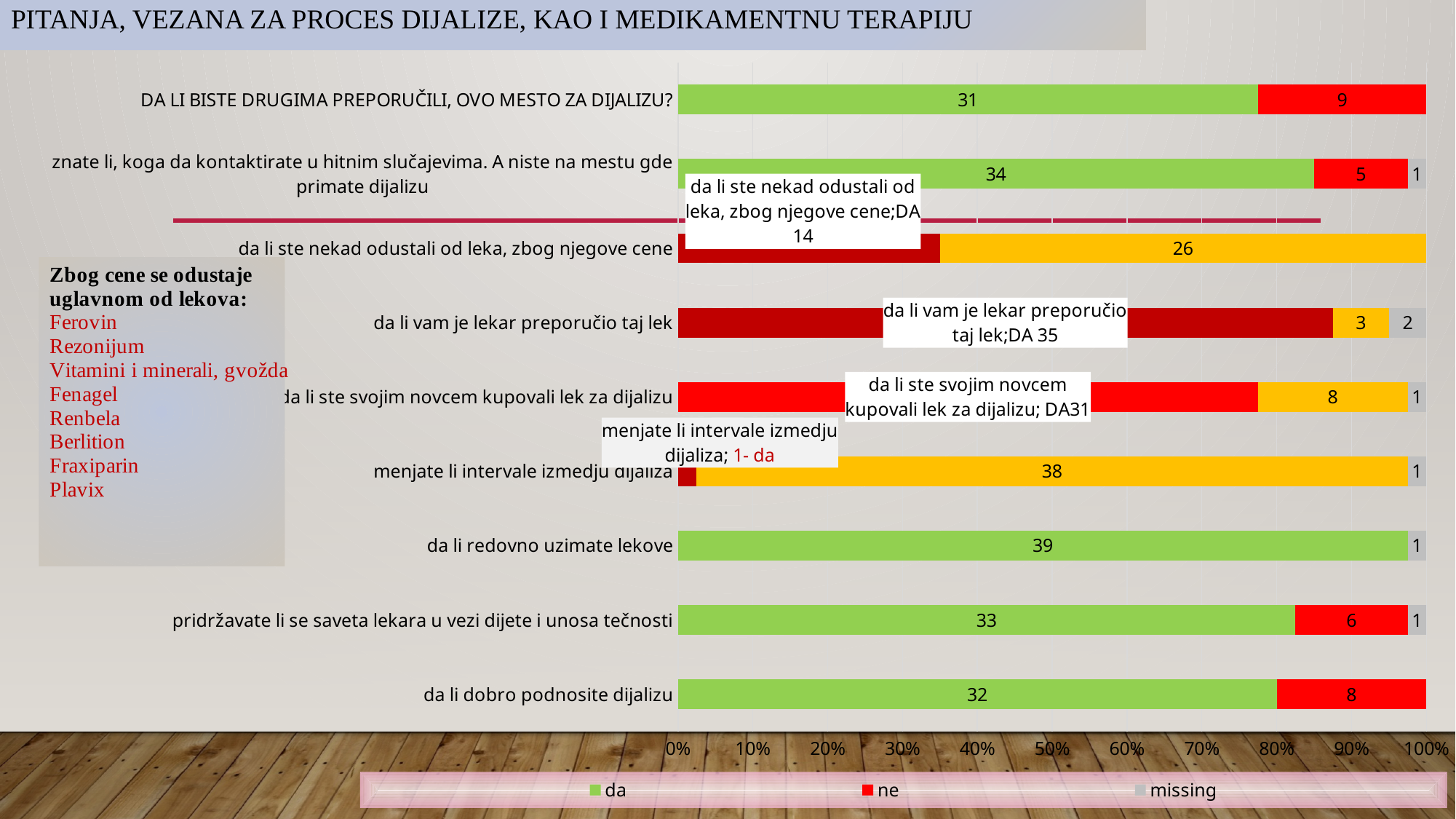
Which has a larger 'da' value: 'da li redovno uzimate lekove' or 'da li dobro podnosite dijalizu'? da li redovno uzimate lekove How many question categories are plotted in the chart? 9 What is the 'da' value for 'da li dobro podnosite dijalizu'? 32 What is the total of all segments in the bar for 'znate li, koga da kontaktirate u hitnim slučajevima. A niste na mestu gde primate dijalizu'? 40 What is the 'ne' value for 'pridržavate li se saveta lekara u vezi dijete i unosa tečnosti'? 6 What is the 'da' value for 'da li redovno uzimate lekove'? 39 What is the 'ne' value for 'DA LI BISTE DRUGIMA PREPORUČILI, OVO MESTO ZA DIJALIZU?'? 9 What type of chart is shown on the slide? bar chart What are the series names listed in the chart legend? da, ne, missing What is the difference between the 'da' and 'ne' values for 'da li dobro podnosite dijalizu'? 24 How many series does the chart legend list? 3 What is the 'da' value for 'da li vam je lekar preporučio taj lek'? 35